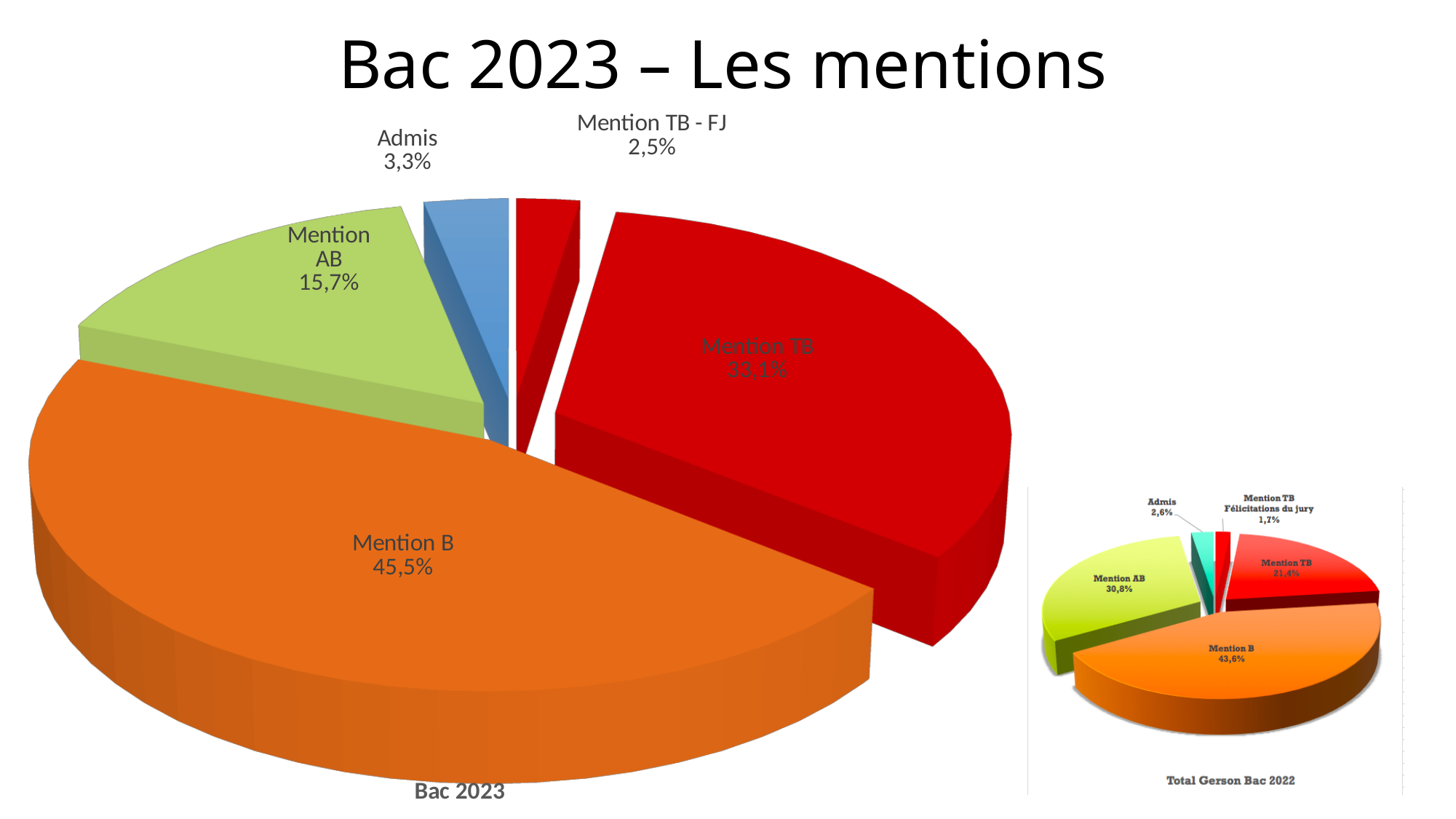
In the Bac 2023 pie chart, what share does Mention B have? 45,5% In the Bac 2023 pie chart, which category has the largest slice? Mention B In the Bac 2023 pie chart, what is the difference in percentage points between Mention B and Mention TB? 12,4 In the Bac 2023 pie chart, what share does Admis have? 3,3% In the Bac 2023 pie chart, how many slices are there? 5 Which is larger: Mention TB in the Bac 2023 chart or Mention TB in the Total Gerson Bac 2022 chart? Bac 2023 In the small Total Gerson Bac 2022 pie chart, what share does Mention TB have? 21,4% In the Bac 2023 pie chart, what share does Mention TB have? 33,1% In the Bac 2023 pie chart, which category has the smallest slice? Mention TB - FJ In the small Total Gerson Bac 2022 pie chart, what share does Mention AB have? 30,8% In the Bac 2023 pie chart, what share does Mention AB have? 15,7% What kind of chart is the large chart labelled Bac 2023? Pie chart